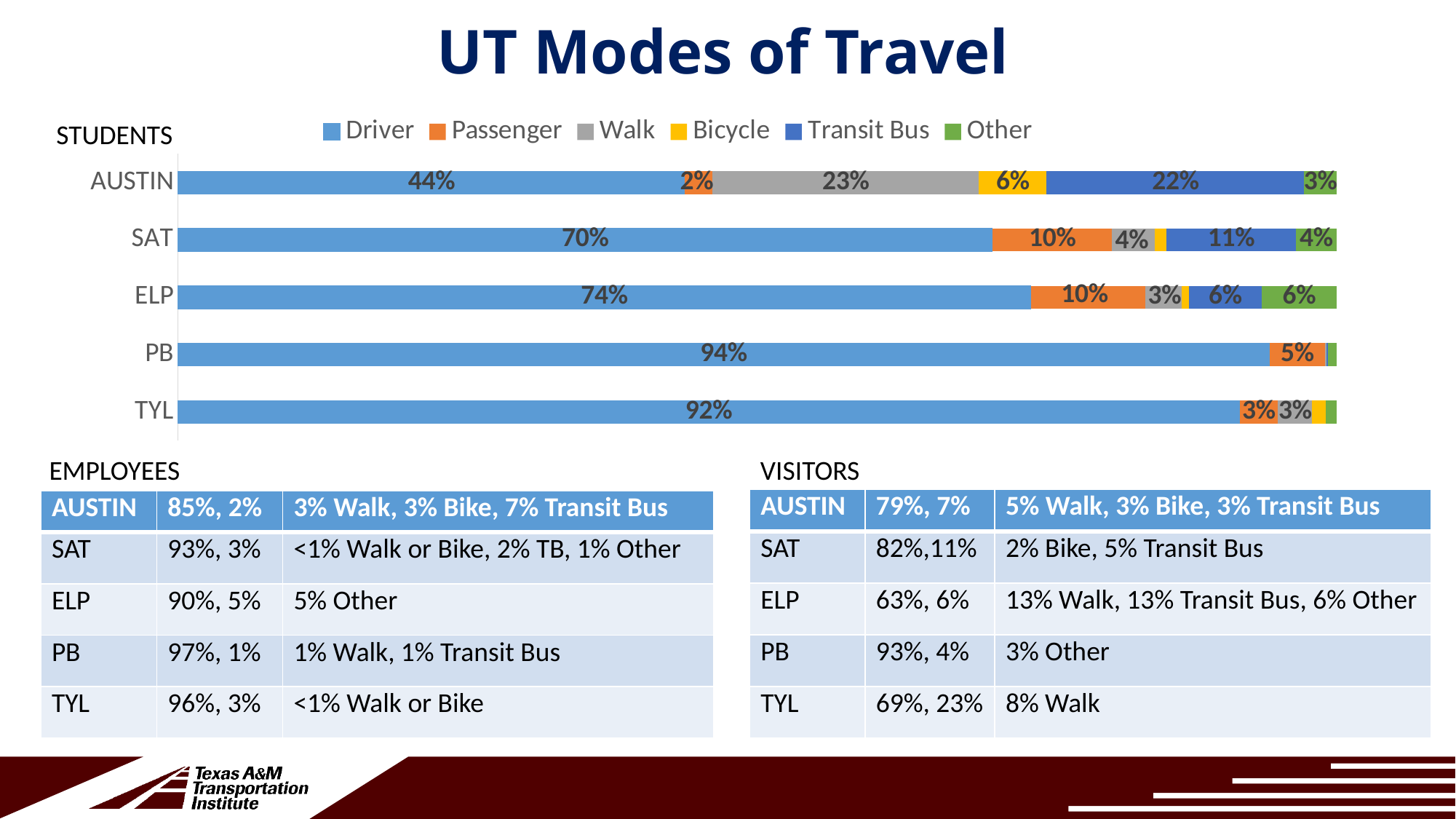
What is the Passenger share for ELP students? 10% Is the Transit Bus share larger for AUSTIN students or for ELP students? AUSTIN What kind of chart is used to show the student modes of travel? Stacked bar chart Which colour represents Transit Bus in the students chart? Dark blue How many campuses are shown in the students chart? 5 What is the difference between the Driver share for PB students and for AUSTIN students? 50% Which campus has the lowest Driver share among students? AUSTIN What is the Transit Bus share for SAT students? 11% What percentage of AUSTIN students travel as Driver? 44% How many series does the legend of the students chart list? 6 Which campus has the highest Driver share among students? PB What percentage of AUSTIN students Walk? 23%